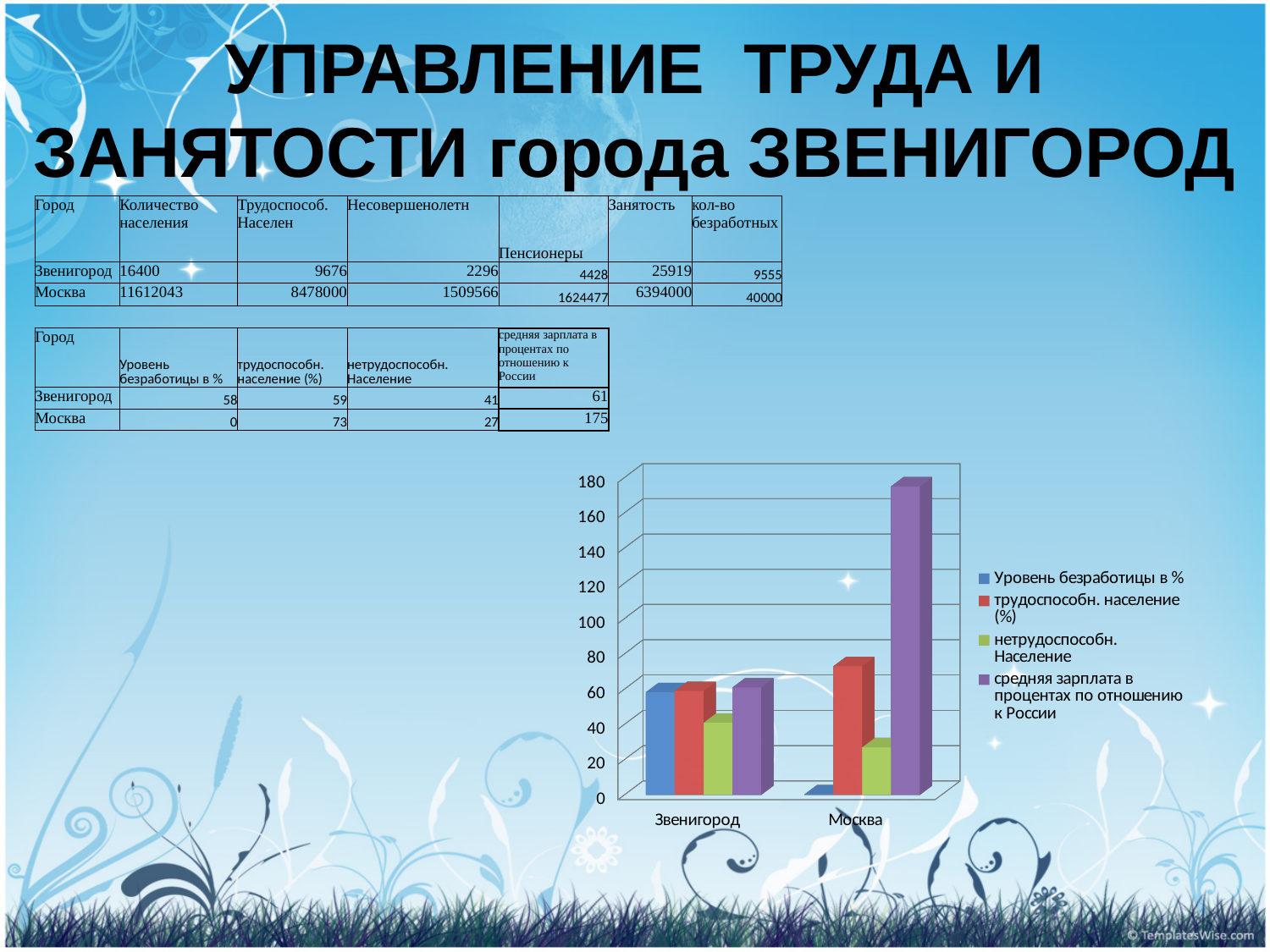
Using the values in the table, what is the difference between Москва and Звенигород for 'средняя зарплата в процентах по отношению к России'? 114 How many categories (cities) are shown on the x axis of the chart? 2 What kind of chart is shown on the slide? bar chart How many series does the chart legend list? 4 Which series has the lowest bar for Москва? Уровень безработицы в % According to the table on the slide, what is the 'Уровень безработицы в %' value for Звенигород plotted in the chart? 58 Is the value for 'средняя зарплата в процентах по отношению к России' for Москва greater or less than 160? greater Is the value for 'нетрудоспособн. Население' for Звенигород greater or less than 60? less What colour represents 'средняя зарплата в процентах по отношению к России' in the chart legend? purple According to the table on the slide, what is the 'средняя зарплата в процентах по отношению к России' value for Москва plotted in the chart? 175 Which city has the larger value for 'трудоспособн. население (%)', Звенигород or Москва? Москва Which city has the higher bar for 'средняя зарплата в процентах по отношению к России'? Москва